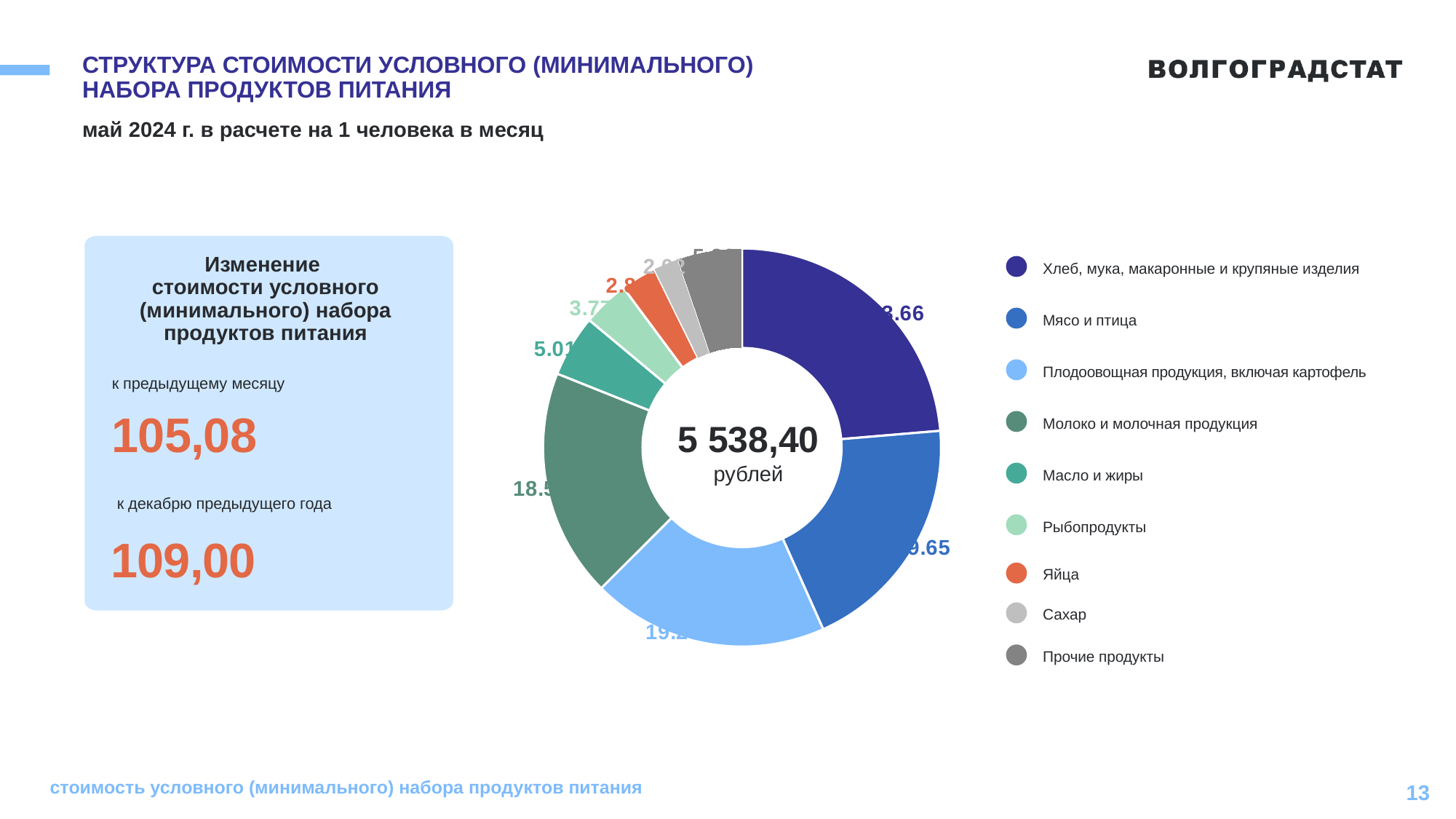
What total value is printed in the centre of the donut chart? 5 538,40 рублей Which category has the smallest share in the donut chart? Сахар What kind of chart is shown on the slide? Pie (donut) chart Which has a larger share: Яйца or Молоко и молочная продукция? Молоко и молочная продукция How many product categories does the legend of the donut chart list? 9 Which has a larger share: Масло и жиры or Рыбопродукты? Масло и жиры What colour represents Яйца in the donut chart? Orange-red Which category has the largest share in the donut chart? Хлеб, мука, макаронные и крупяные изделия Which has a larger share: Хлеб, мука, макаронные и крупяные изделия or Мясо и птица? Хлеб, мука, макаронные и крупяные изделия What is the value shown for Масло и жиры in the donut chart? 5.01 Which category is shown in dark grey in the donut chart? Прочие продукты